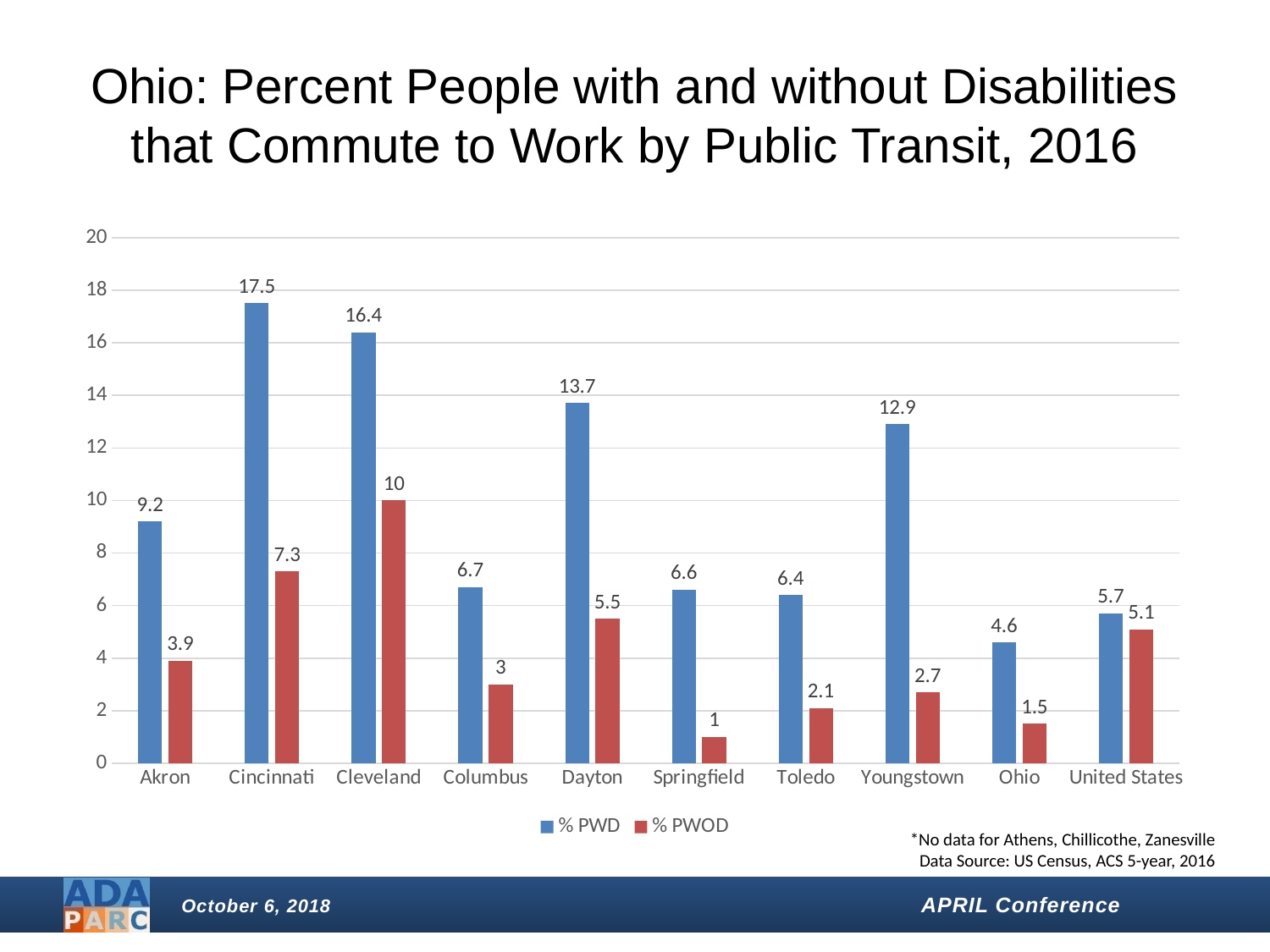
What colour are the % PWOD bars? red What is the % PWD value for the United States? 5.7 Which category has the lowest % PWOD value? Springfield Which category has the highest % PWD value? Cincinnati What is the % PWOD value for Cleveland? 10 What is the % PWD value for Cincinnati? 17.5 How many categories are shown on the x axis? 10 What kind of chart is shown on the slide? bar chart Is the % PWD value for Youngstown greater or less than 12? greater What is the difference between the % PWD and % PWOD values for Dayton? 8.2 How many series does the legend list? 2 Which is larger for Ohio: the % PWD value or the % PWOD value? % PWD